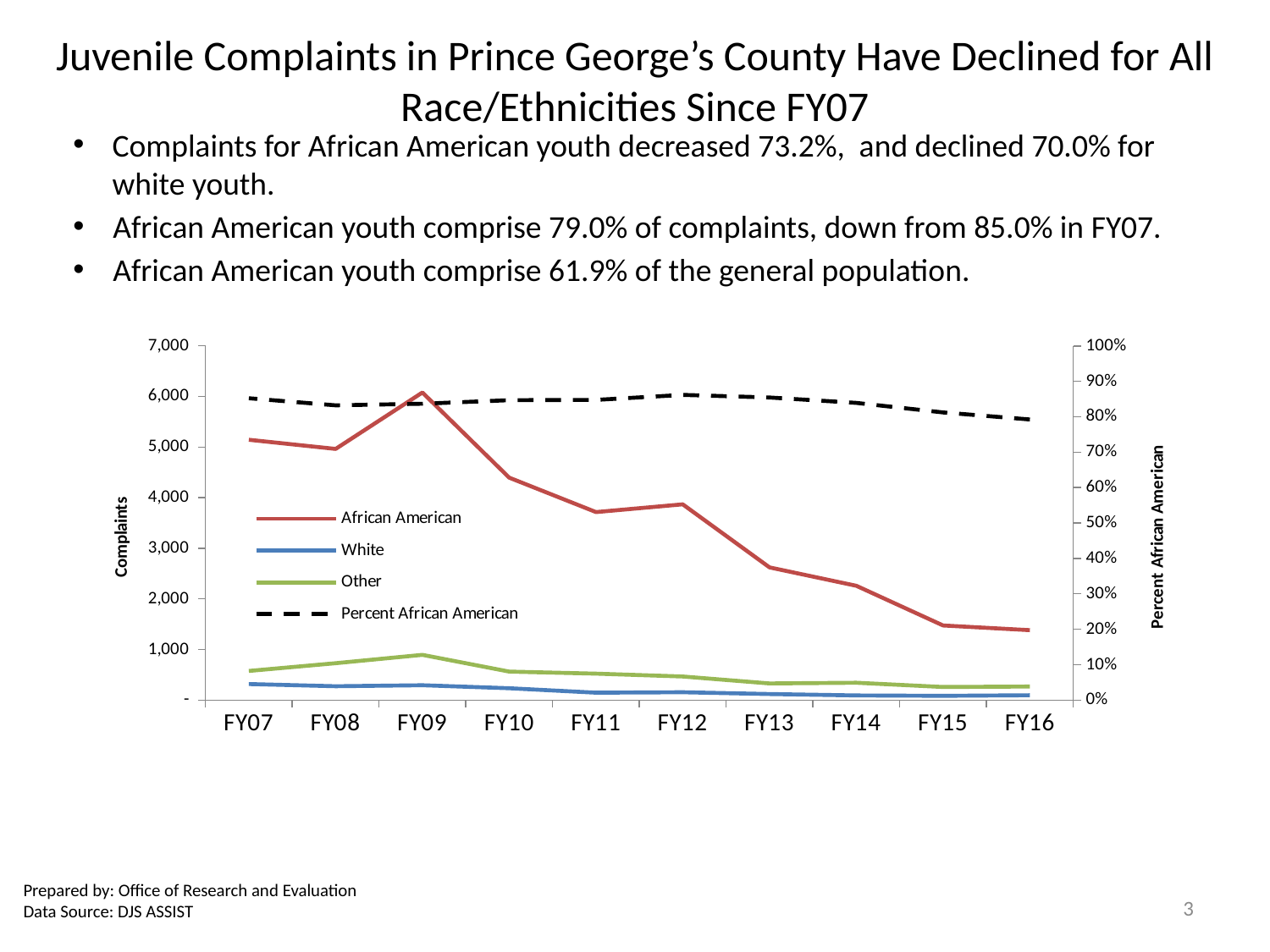
Is the value for African American complaints in FY09 greater or less than 5,000? greater Does the African American complaints line generally rise or fall from FY09 to FY16? fall What kind of chart is shown on the slide? line chart How many fiscal years are plotted along the x axis of the chart? 10 What is the title of the left vertical axis of the chart? Complaints Is the Percent African American value in FY16 greater or less than 90%? less Is the value for African American complaints in FY16 greater or less than 2,000? less In FY09, which series has more complaints, Other or White? Other In which fiscal year does the African American complaints line reach its highest point? FY09 Which series has the highest number of complaints across all years shown? African American How many series does the chart's legend list? 4